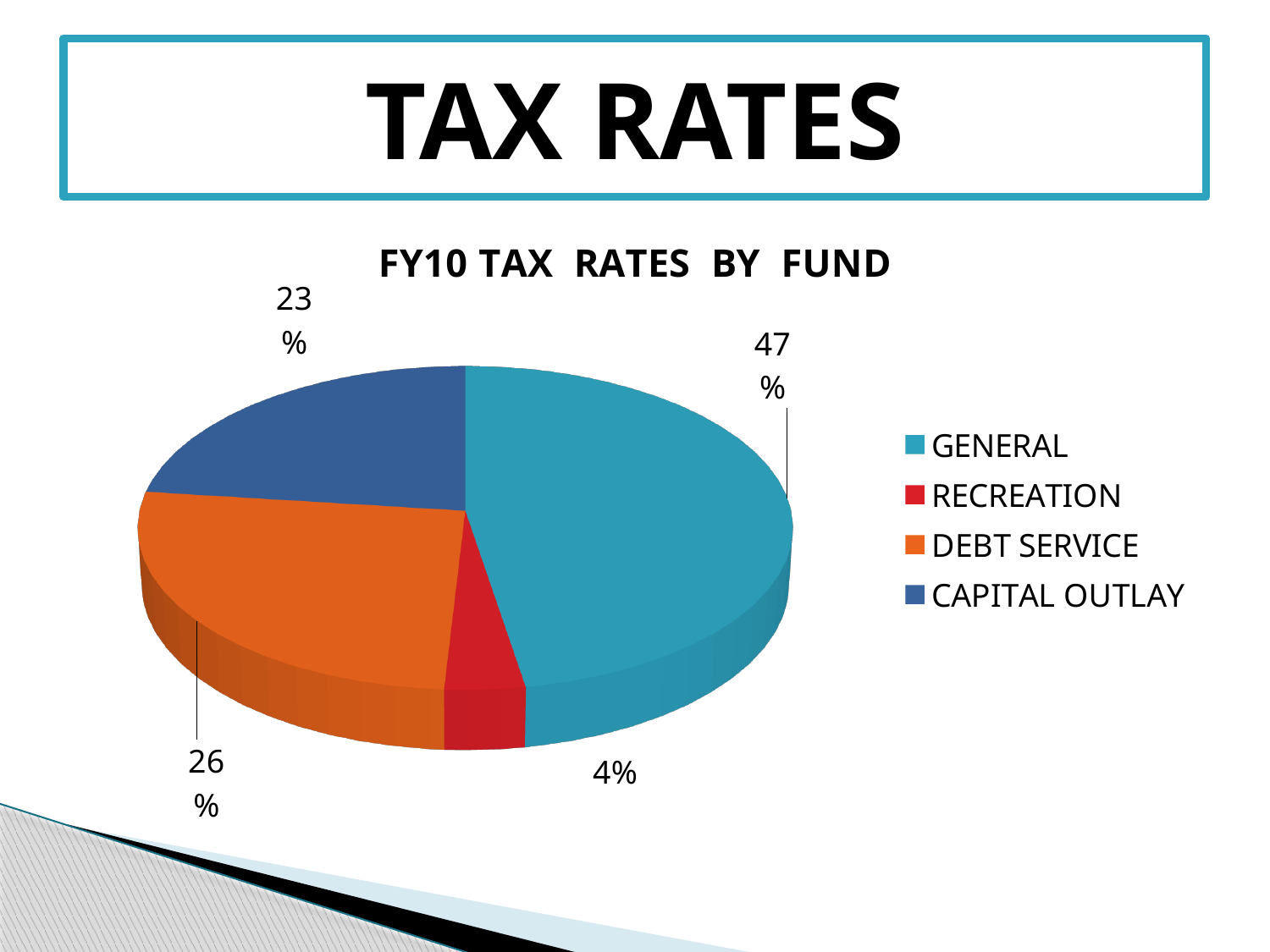
How many funds are shown in the pie chart? 4 What type of chart is shown on the slide? Pie chart What share of the pie does GENERAL represent? 47% What share of the pie does CAPITAL OUTLAY represent? 23% What share of the pie does DEBT SERVICE represent? 26% What is the difference in percentage points between the GENERAL and DEBT SERVICE shares? 21 What is the chart's title? FY10 TAX RATES BY FUND Which fund has the smallest share of the pie? RECREATION Which fund has the largest share of the pie? GENERAL Which is larger, the DEBT SERVICE share or the CAPITAL OUTLAY share? DEBT SERVICE Which colour represents DEBT SERVICE in the legend? Orange